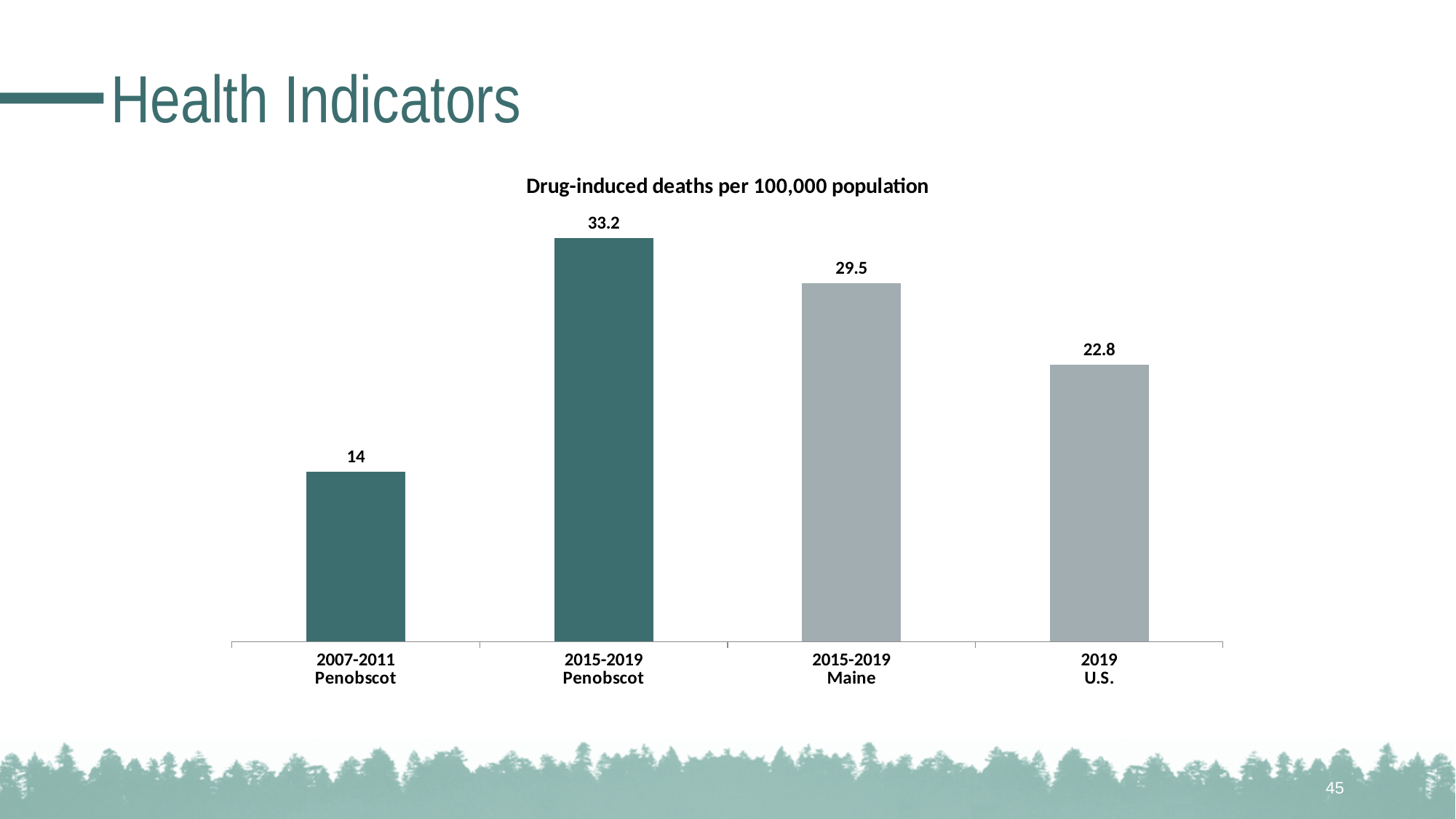
What is the value for 2015-2019 Maine? 29.5 What kind of chart is shown on the slide? Bar chart What is the title of the chart? Drug-induced deaths per 100,000 population What is the difference between the 2015-2019 Penobscot value and the 2007-2011 Penobscot value? 19.2 What is the difference between the 2015-2019 Maine value and the 2019 U.S. value? 6.7 What is the value for 2015-2019 Penobscot? 33.2 Which category has the lowest value? 2007-2011 Penobscot Which is larger, the value for 2015-2019 Maine or the value for 2019 U.S.? 2015-2019 Maine How many bars are shown in the chart? 4 Which category has the highest value? 2015-2019 Penobscot What is the value for 2019 U.S.? 22.8 What is the value for 2007-2011 Penobscot? 14